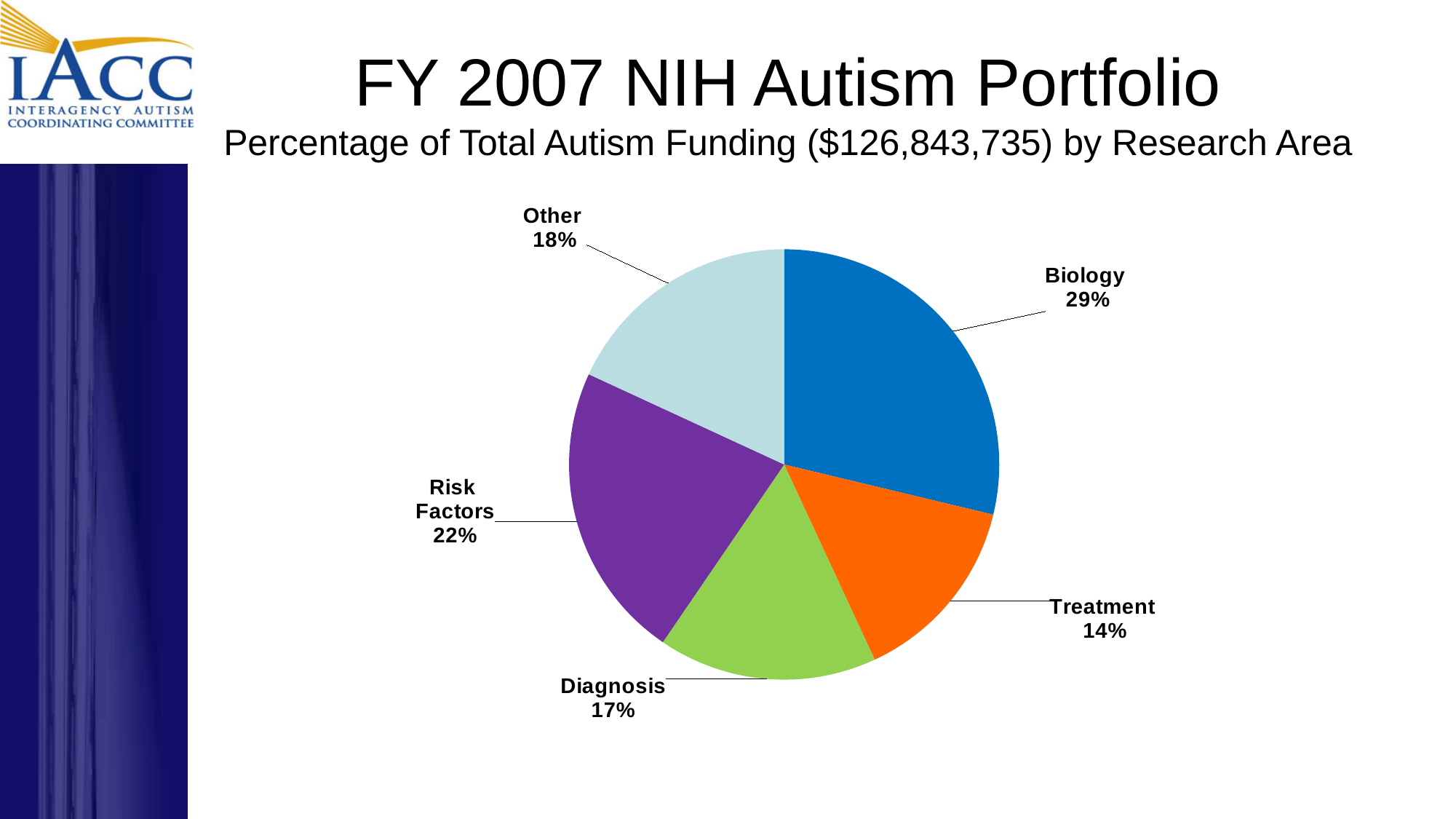
What percentage of total autism funding goes to Risk Factors? 22% What percentage of total autism funding goes to Biology? 29% What is the difference in percentage points between Biology and Treatment? 15 What percentage of total autism funding goes to Treatment? 14% Which research area receives the largest share of funding? Biology What type of chart is shown on the slide? Pie chart How many research areas are shown in the pie chart? 5 Which receives a larger share of funding, Risk Factors or Other? Risk Factors Which research area receives the smallest share of funding? Treatment What colour is the Diagnosis slice? Green What percentage of total autism funding goes to Diagnosis? 17% What is the total autism funding amount stated in the chart subtitle? $126,843,735